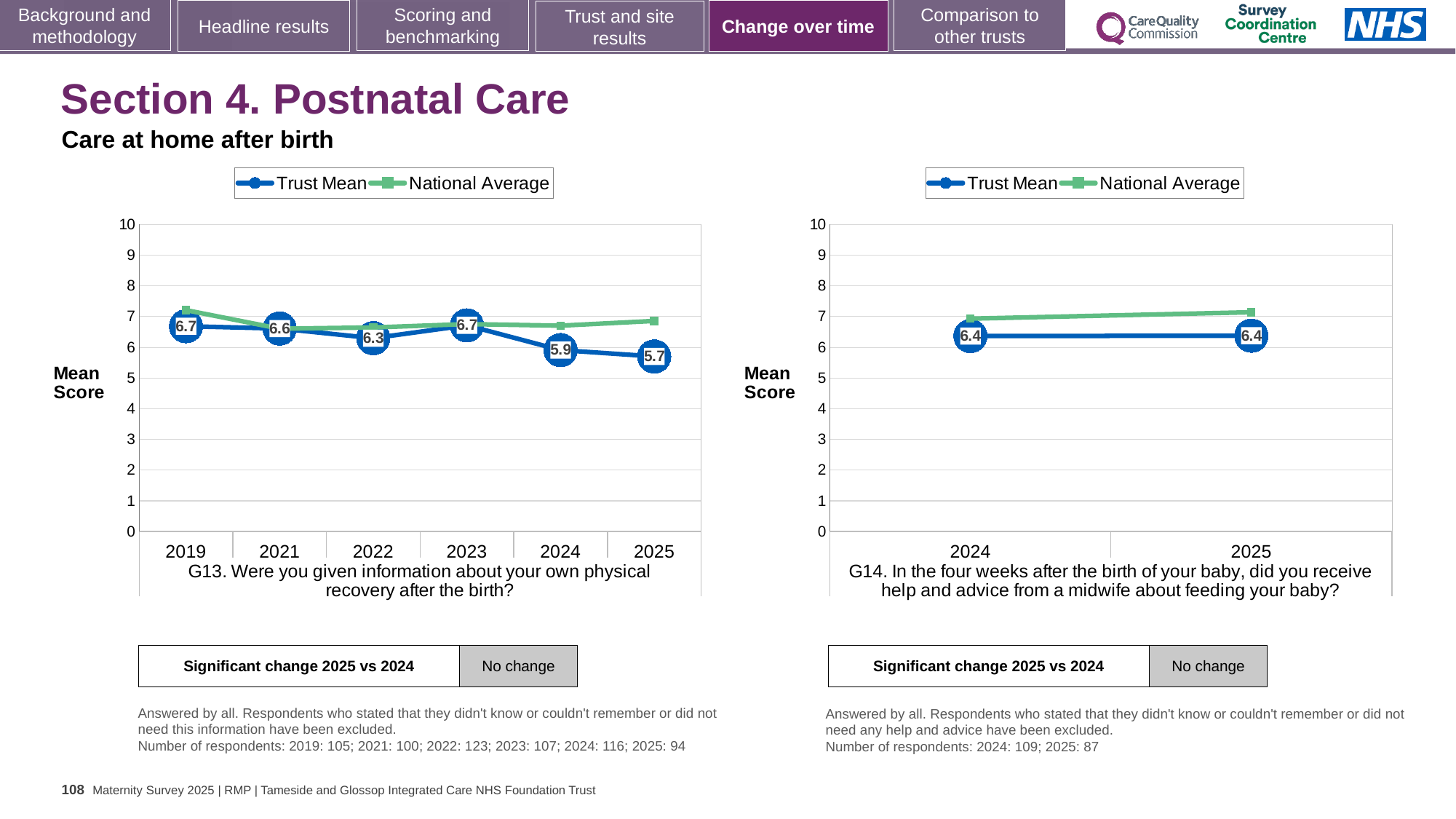
What type of chart is the G14 chart (right)? line chart On the G14 chart (right), is the National Average for 2025 greater or less than 7? greater On the G13 chart (left), is the Trust Mean higher in 2021 or in 2024? 2021 On the G13 chart (left), how many years are shown on the x axis? 6 On the G13 chart (left), what is the Trust Mean for 2022? 6.3 On the G13 chart (left), what is the Trust Mean for 2025? 5.7 On the G14 chart (right), how many series does the legend list? 2 On the G13 chart (left), does the Trust Mean rise or fall from 2023 to 2025? fall On the G14 chart (right), what is the Trust Mean for 2024? 6.4 On the G13 chart (left), what is the difference between the Trust Mean in 2023 and in 2025? 1.0 On the G13 chart (left), which year has the lowest Trust Mean? 2025 On the G13 chart (left), is the National Average for 2025 greater or less than 6? greater